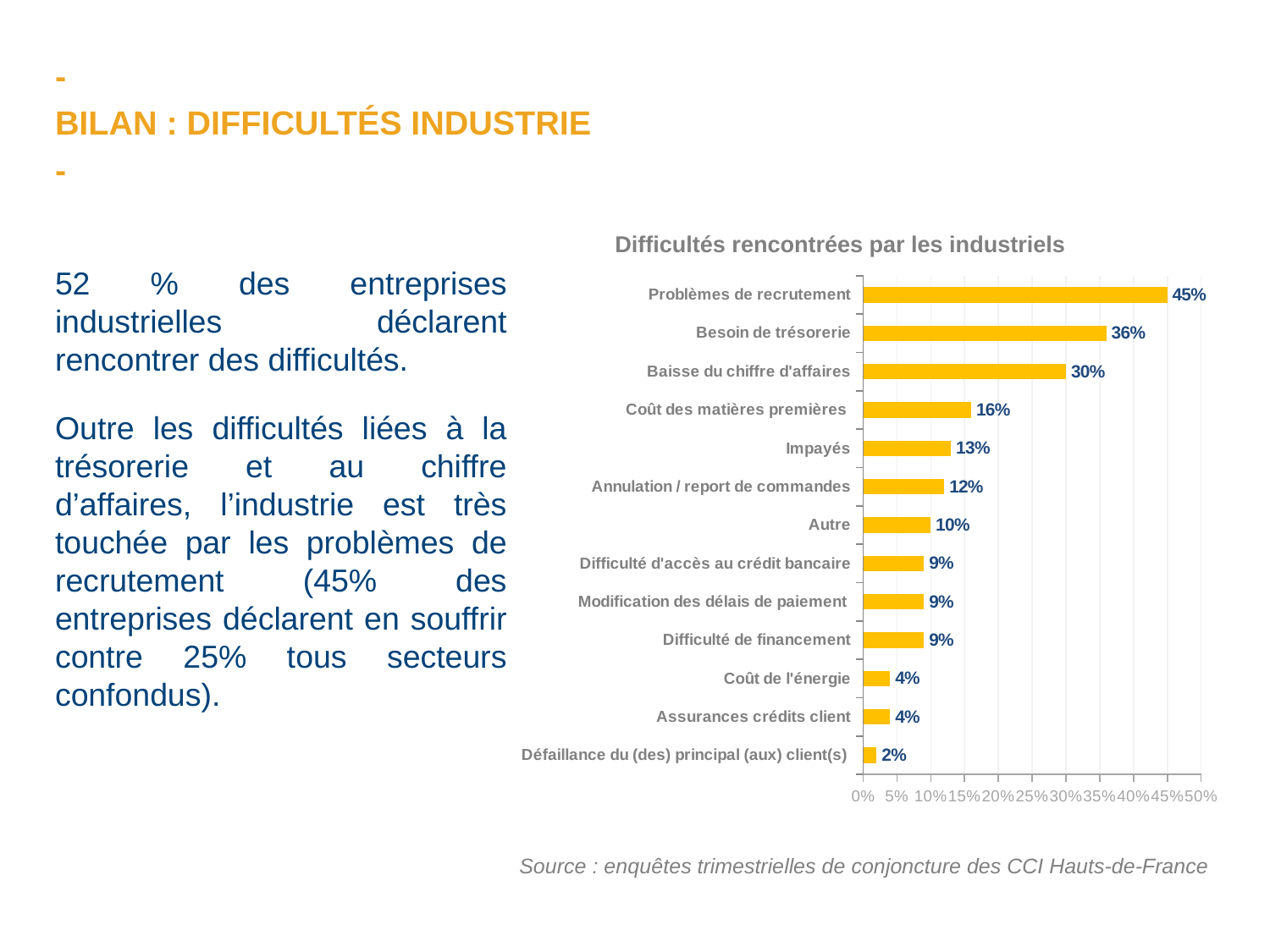
What is the difference between Besoin de trésorerie and Baisse du chiffre d'affaires? 6% What is the value for Problèmes de recrutement? 45% What is the value for Coût des matières premières? 16% How many categories are shown in the chart? 13 Which category has the lowest value? Défaillance du (des) principal (aux) client(s) What is the title of the chart? Difficultés rencontrées par les industriels Which category has the highest value? Problèmes de recrutement What is the value for Annulation / report de commandes? 12% Which is larger, Impayés or Autre? Impayés Is the value for Baisse du chiffre d'affaires greater or less than 25%? greater What is the difference between Problèmes de recrutement and Impayés? 32% What kind of chart is shown? bar chart